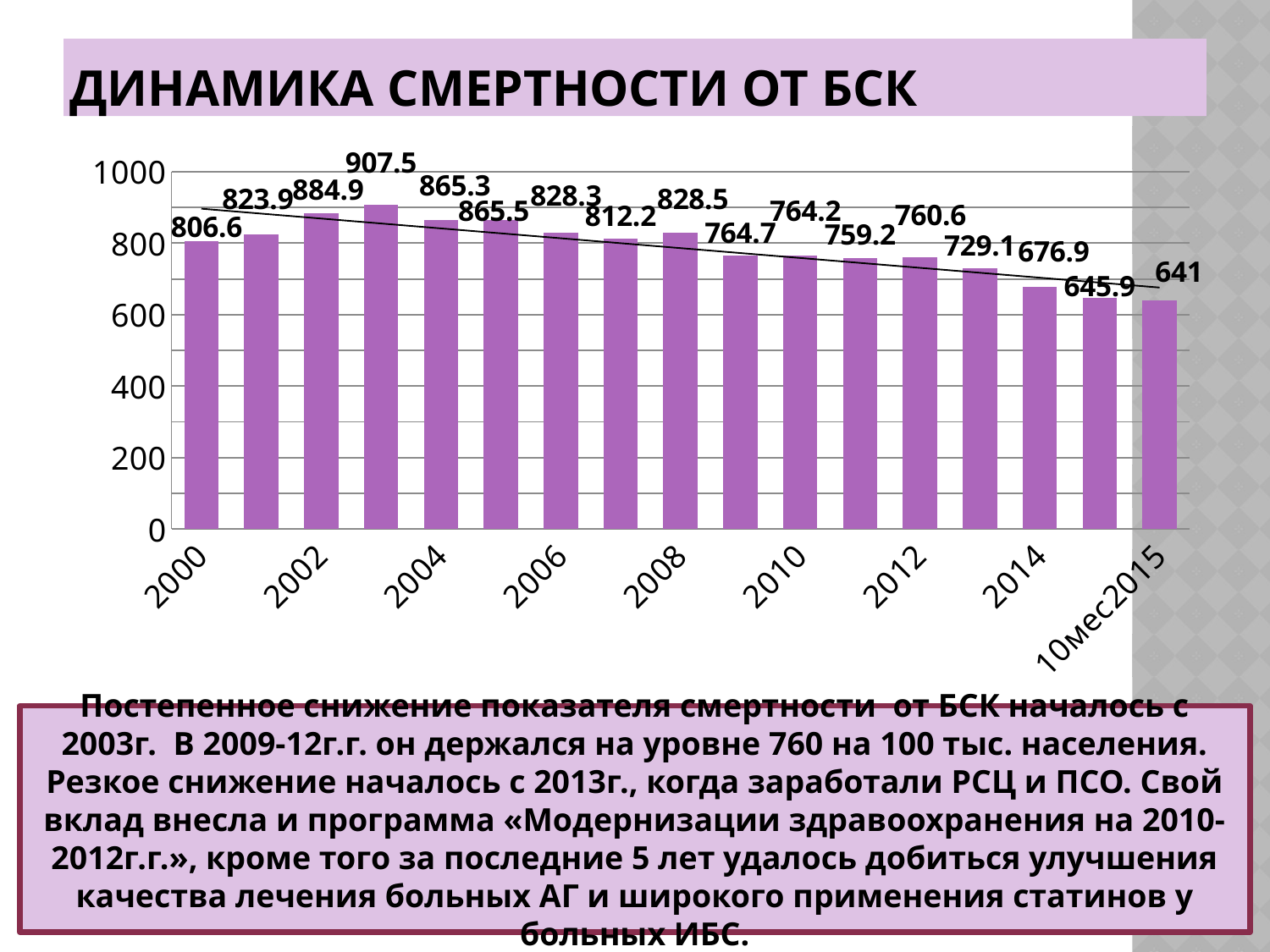
What is the value for 2002? 884.9 Which category has the lowest value? 10мес2015 What is the highest value shown on the chart? 907.5 What is the title of the chart? ДИНАМИКА СМЕРТНОСТИ ОТ БСК What type of chart is shown on the slide? bar chart What is the value for 2014? 676.9 Is the value for 2014 greater or less than 800? less Which is larger, the value for 2010 or the value for 2014? 2010 What is the value for 10мес2015? 641 What is the value for 2000? 806.6 What is the difference between the values for 2000 and 10мес2015? 165.6 Do the values generally rise or fall from 2003 onward along the x axis? fall